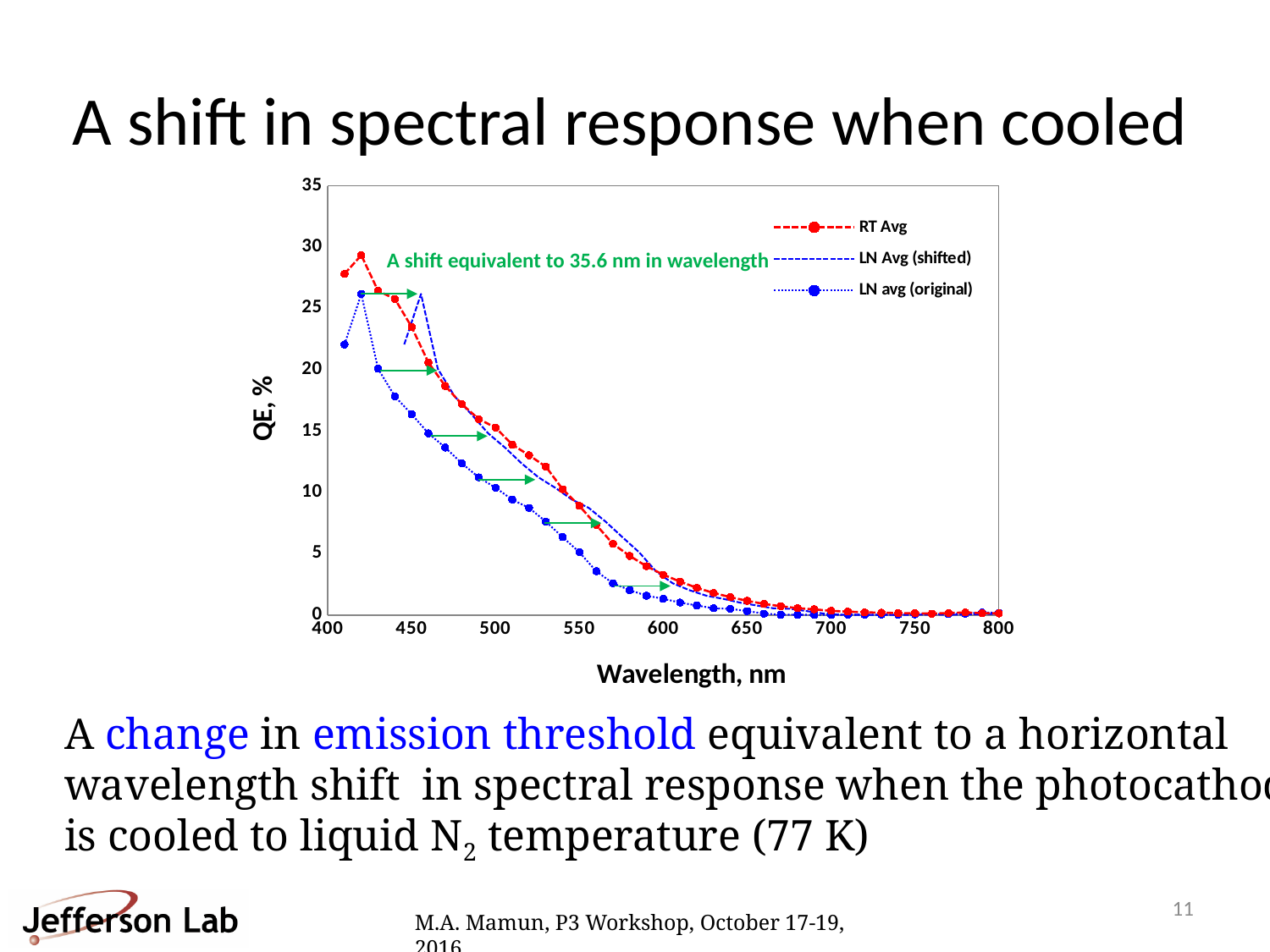
What are the three series named in the legend? RT Avg, LN Avg (shifted), LN avg (original) Is the value of the RT Avg series at 600 nm greater or less than 5? less How many series does the legend list? 3 Is the value of the LN avg (original) series at 500 nm greater or less than 15? less At 500 nm, which series has the larger QE value: RT Avg or LN avg (original)? RT Avg What kind of chart is shown on the slide? line chart What is the label of the x axis? Wavelength, nm What is the maximum value shown on the y axis? 35 Do the QE values of the RT Avg series rise or fall as wavelength increases from 450 nm to 800 nm? fall Which series reaches the highest QE value on the chart? RT Avg Is the value of the LN avg (original) series at 410 nm greater or less than 20? greater